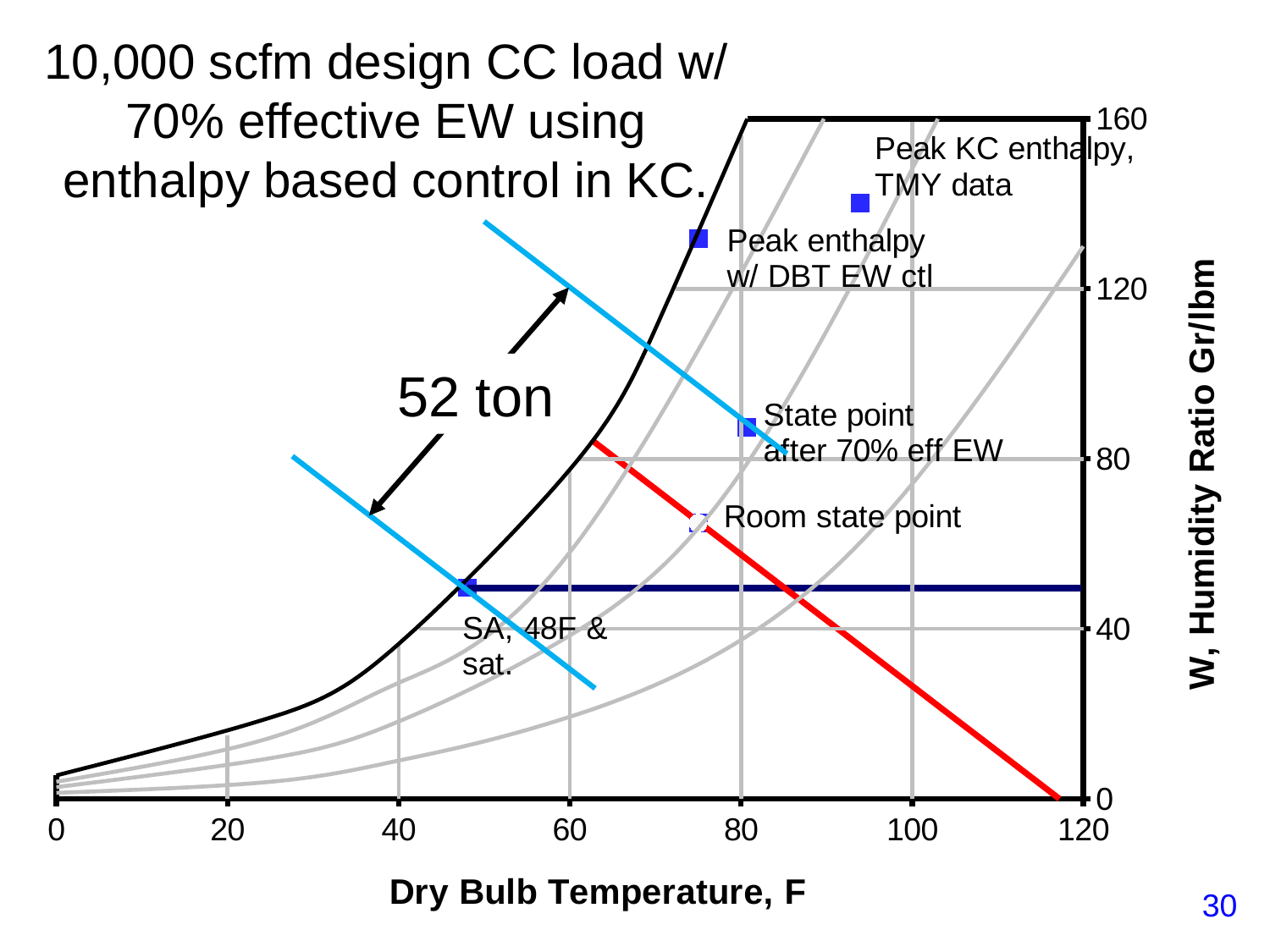
Is the humidity ratio of the 'Room state point' greater or less than 80 Gr/lbm? less What is the highest value shown on the Dry Bulb Temperature axis? 120 Is the humidity ratio of the 'State point after 70% eff EW' greater or less than 80 Gr/lbm? greater What cooling load in tons is annotated between the two light blue lines on the chart? 52 ton What is the title of the chart on the slide? 10,000 scfm design CC load w/ 70% effective EW using enthalpy based control in KC. According to its label, what is the dry bulb temperature of the SA (supply air) state point? 48F Which labeled point has the highest humidity ratio: 'Peak KC enthalpy, TMY data' or 'Room state point'? Peak KC enthalpy, TMY data Is the dry bulb temperature of the 'Peak KC enthalpy, TMY data' point greater or less than 80 F? greater What is the highest value shown on the vertical axis (W, Humidity Ratio Gr/lbm)? 160 What is the label of the horizontal axis of the chart? Dry Bulb Temperature, F How many labeled state points are marked on the chart? 5